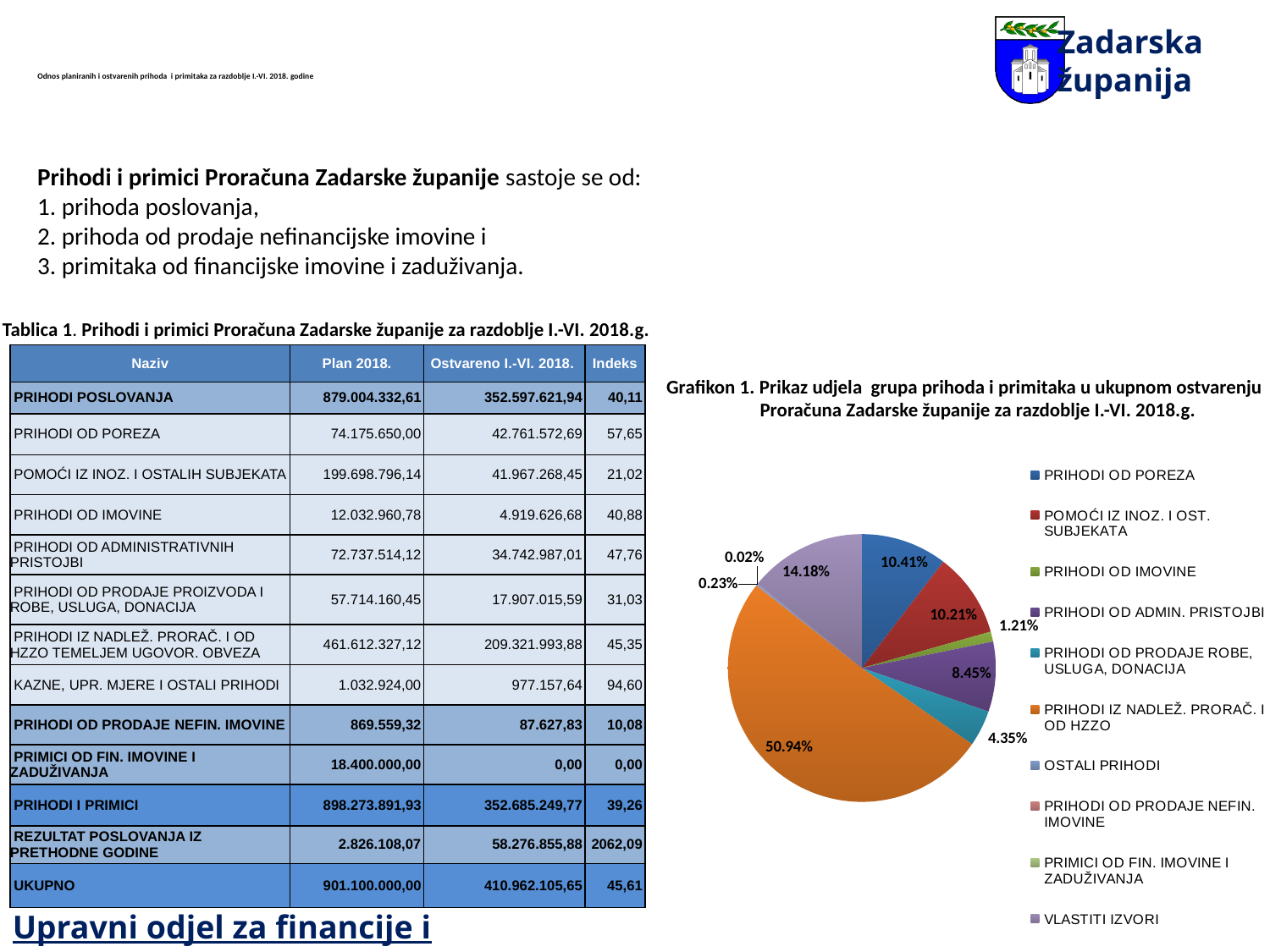
What colour is the slice for PRIHODI IZ NADLEŽ. PRORAČ. I OD HZZO in the pie chart? orange How many entries does the legend of the pie chart list? 10 What type of chart is Grafikon 1 on the slide? pie chart In the pie chart, which is larger: the share for PRIHODI OD POREZA or the share for PRIHODI OD ADMIN. PRISTOJBI? PRIHODI OD POREZA Which category has the largest slice in the pie chart? PRIHODI IZ NADLEŽ. PRORAČ. I OD HZZO In the pie chart, what share is shown for PRIHODI OD IMOVINE? 1.21% In the pie chart, what share is shown for PRIHODI OD POREZA? 10.41% In the pie chart, what share is shown for PRIHODI IZ NADLEŽ. PRORAČ. I OD HZZO? 50.94% Which of the labelled slices in the pie chart is the smallest? PRIHODI OD PRODAJE NEFIN. IMOVINE (0.02%) In the pie chart, what is the difference between the share for VLASTITI IZVORI and the share for PRIHODI OD PRODAJE ROBE, USLUGA, DONACIJA? 9.83% In the pie chart, what share is shown for VLASTITI IZVORI? 14.18% In the pie chart, what share is shown for PRIHODI OD ADMIN. PRISTOJBI? 8.45%